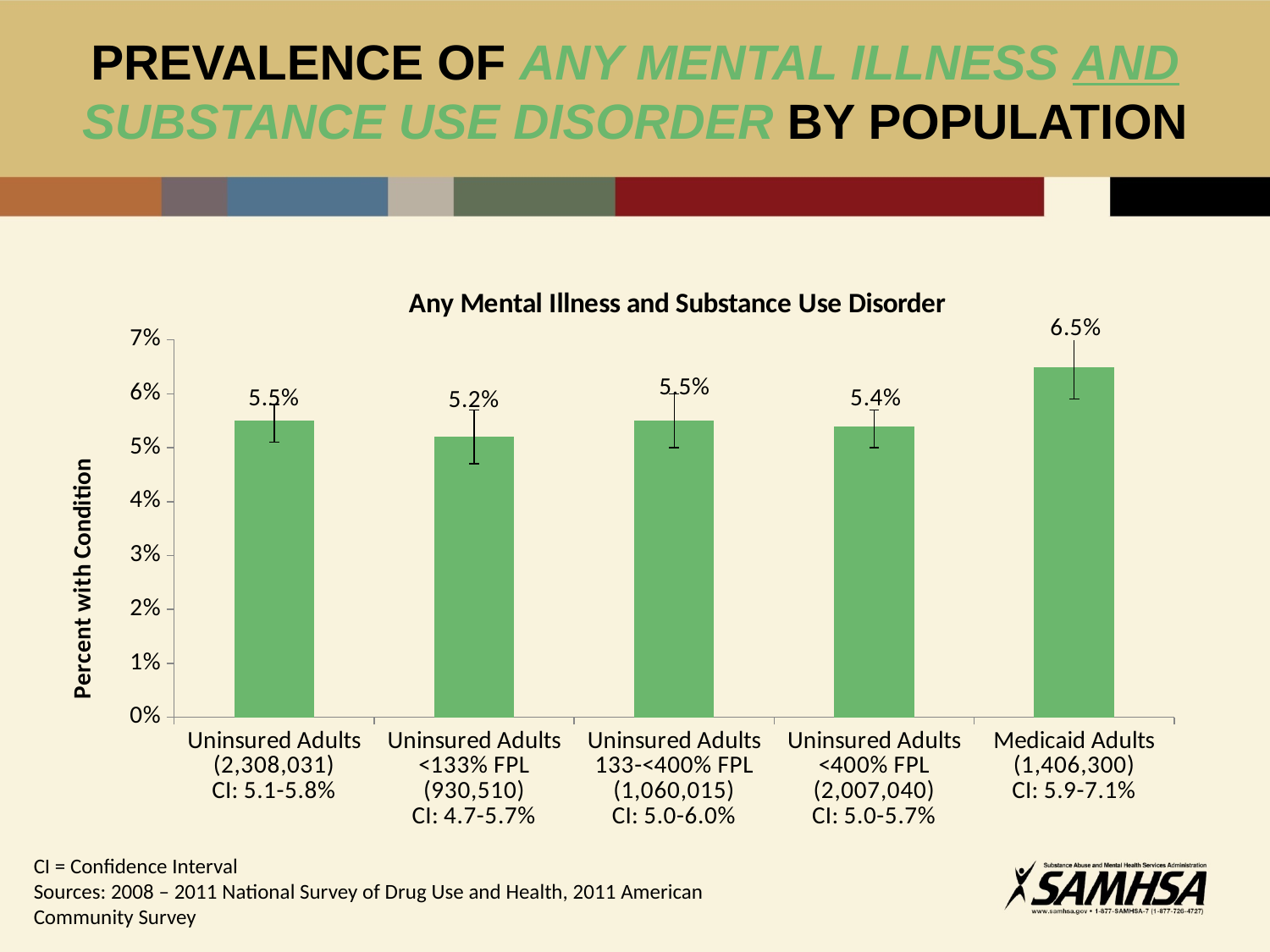
What is the value for Uninsured Adults <133% FPL? 5.2% Is the value for Medicaid Adults greater or less than 6%? greater What kind of chart is this? bar chart Which category has the lowest value? Uninsured Adults <133% FPL Which is larger, the value for Medicaid Adults or the value for Uninsured Adults <400% FPL? Medicaid Adults What is the value for Medicaid Adults? 6.5% What is the difference between the values for Medicaid Adults and Uninsured Adults <133% FPL? 1.3% Which category has the highest value? Medicaid Adults How many categories are shown on the x axis? 5 What is the title of the chart? Any Mental Illness and Substance Use Disorder What is the value for Uninsured Adults <400% FPL? 5.4% What is the value for Uninsured Adults 133-<400% FPL? 5.5%